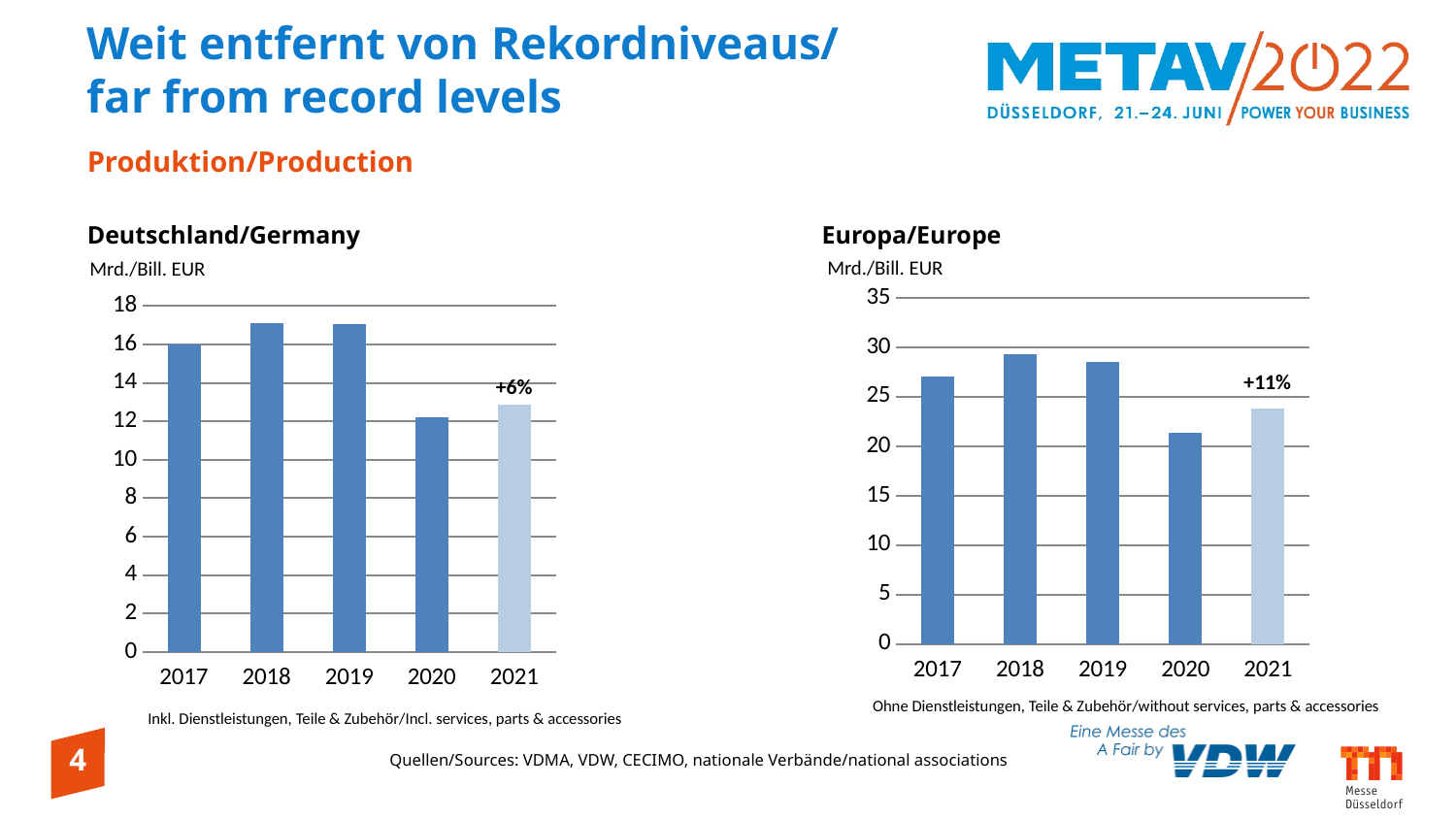
What percentage change is annotated above the 2021 bar in the Europa/Europe chart? +11% In the Deutschland/Germany chart, is the value for 2020 greater or less than 14? less In the Europa/Europe chart, is the value for 2021 greater or less than 25? less In the Deutschland/Germany chart, which year has the lowest bar? 2020 In the Europa/Europe chart, which year has the lowest bar? 2020 In the Deutschland/Germany chart, is the value for 2018 greater or less than 16? greater How many years are shown on the x axis of the Europa/Europe chart? 5 In the Deutschland/Germany chart, which is larger, the value for 2017 or the value for 2021? 2017 In the Europa/Europe chart, which year has the highest bar? 2018 What kind of chart is the Deutschland/Germany chart? bar chart What unit is given for the values in the Deutschland/Germany chart? Mrd./Bill. EUR